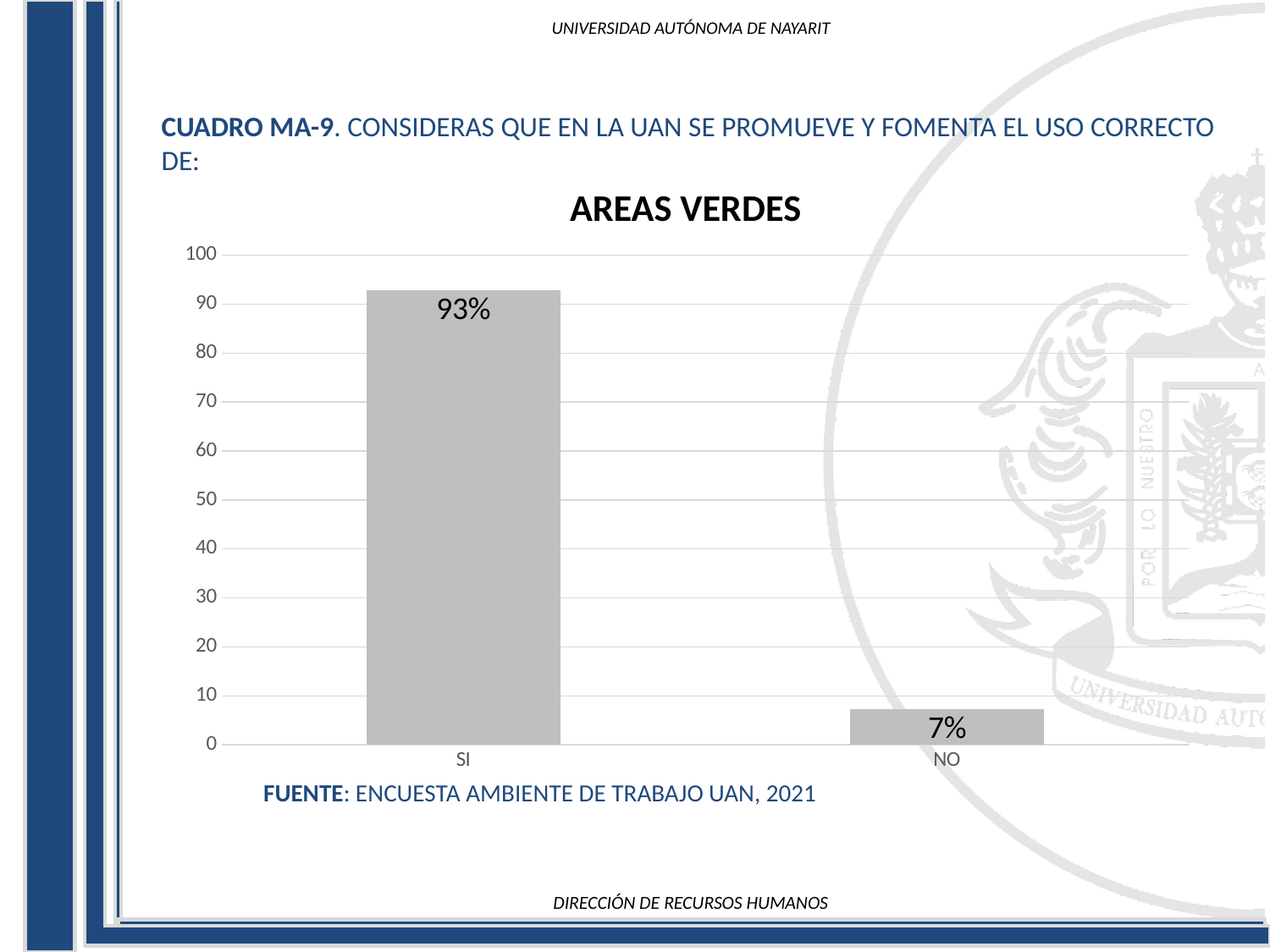
Which category has the lowest value? NO Is the value for NO greater or less than 10? less Which is larger, the value for SI or the value for NO? SI What kind of chart is shown? bar chart What is the difference between the values for SI and NO? 86% Is the value for SI greater or less than 90? greater Which category has the highest value? SI How many categories are shown on the x axis? 2 What is the value for SI? 93% What is the value for NO? 7% What is the title of the chart? AREAS VERDES What is the maximum value shown on the y axis? 100